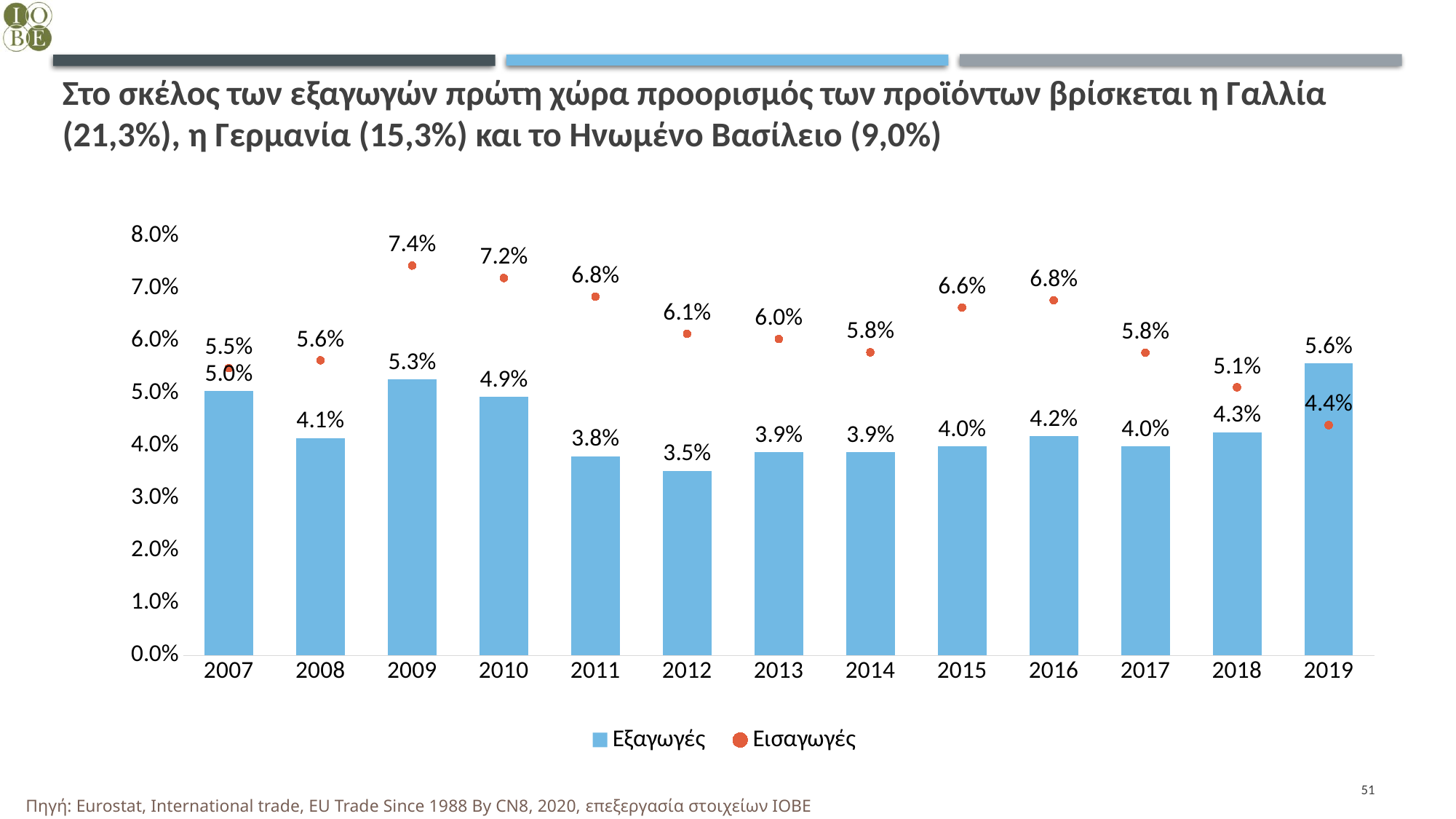
What kind of chart is used to show the Εξαγωγές series? Bar chart Which year has the highest Εισαγωγές value? 2009 Which year has the lowest Εξαγωγές value? 2012 What is the value of Εισαγωγές for 2018? 5.1% How many years are shown on the x axis? 13 What is the value of Εξαγωγές for 2019? 5.6% What is the value of Εξαγωγές for 2012? 3.5% What is the value of Εισαγωγές for 2009? 7.4% How many series does the legend list? 2 What is the difference between Εισαγωγές and Εξαγωγές in 2010? 2.3% Which is larger in 2019, Εξαγωγές or Εισαγωγές? Εξαγωγές What colour are the Εισαγωγές markers? Orange-red